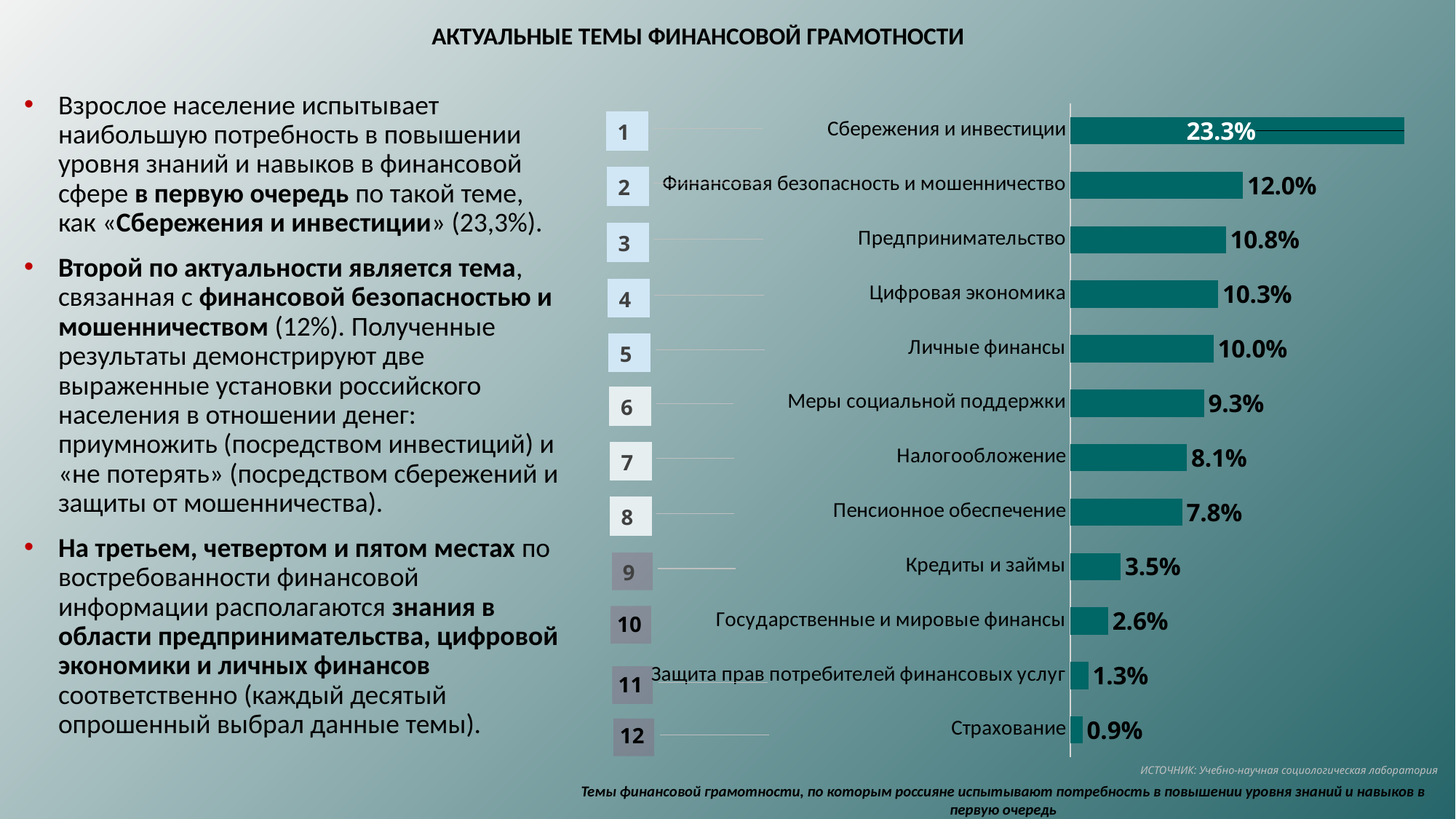
What is the value for Цифровая экономика? 10.3% What is the value for Страхование? 0.9% What is the difference between the values for Кредиты и займы and Государственные и мировые финансы? 0.9% What is the value for Сбережения и инвестиции? 23.3% What is the value for Пенсионное обеспечение? 7.8% Which category has the lowest value? Страхование What kind of chart is shown on the slide? Bar chart Which category has the highest value? Сбережения и инвестиции How many categories are shown in the chart? 12 Which is larger, the value for Налогообложение or the value for Меры социальной поддержки? Меры социальной поддержки What is the difference between the values for Сбережения и инвестиции and Финансовая безопасность и мошенничество? 11.3% What is the value for Предпринимательство? 10.8%